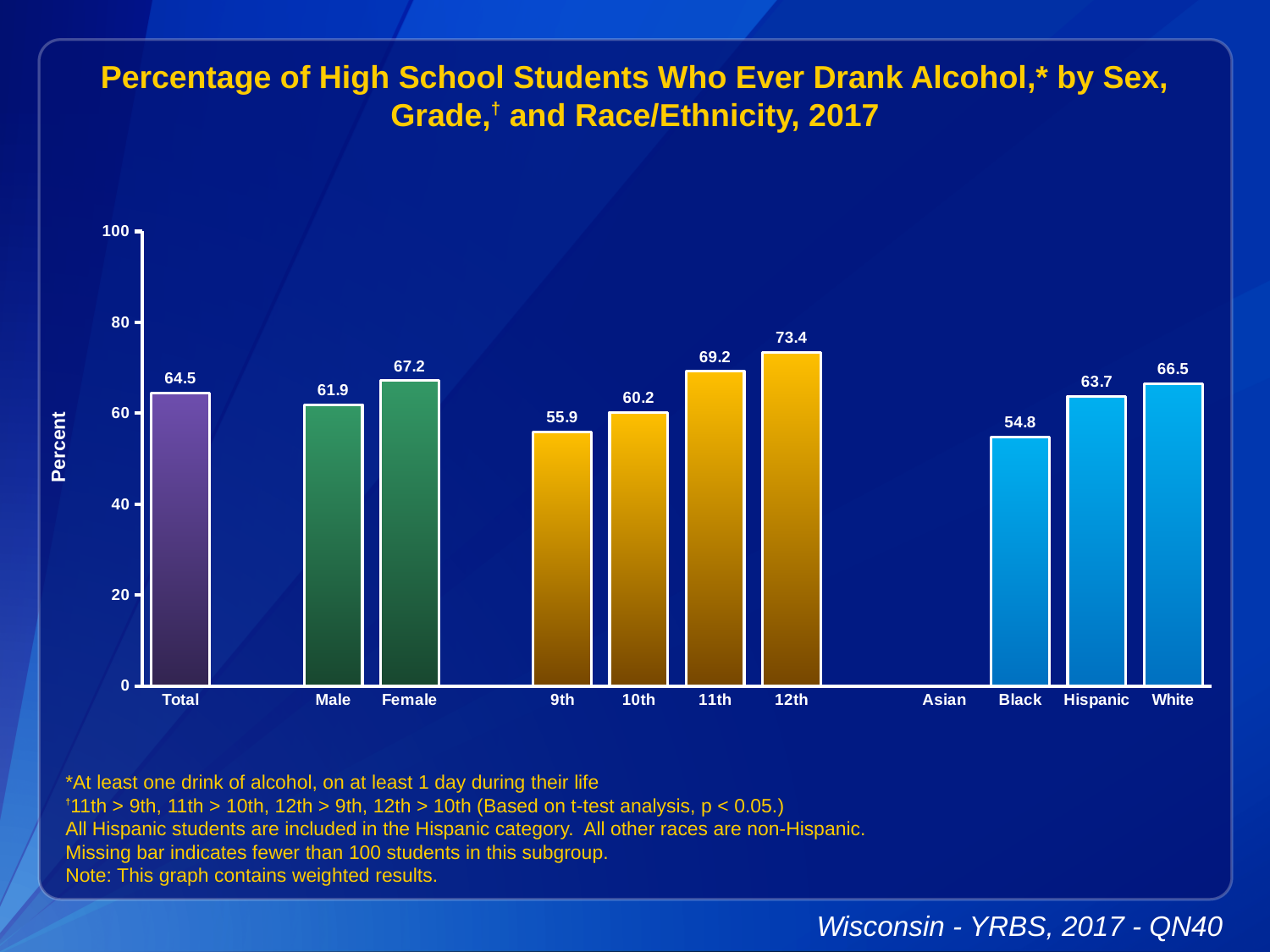
Is the value for 11th grade greater or less than 60? greater How many bars are plotted on the chart? 10 Which category has the highest value? 12th What kind of chart is shown? Bar chart Which is larger, the value for Hispanic or the value for White? White What is the value for Female? 67.2 What is the value for 12th grade? 73.4 What is the difference between the 12th and 9th grade values? 17.5 What is the value for Black students? 54.8 What is the value for Total? 64.5 Which category has the lowest plotted value? Black What is the difference between the Female and Male values? 5.3